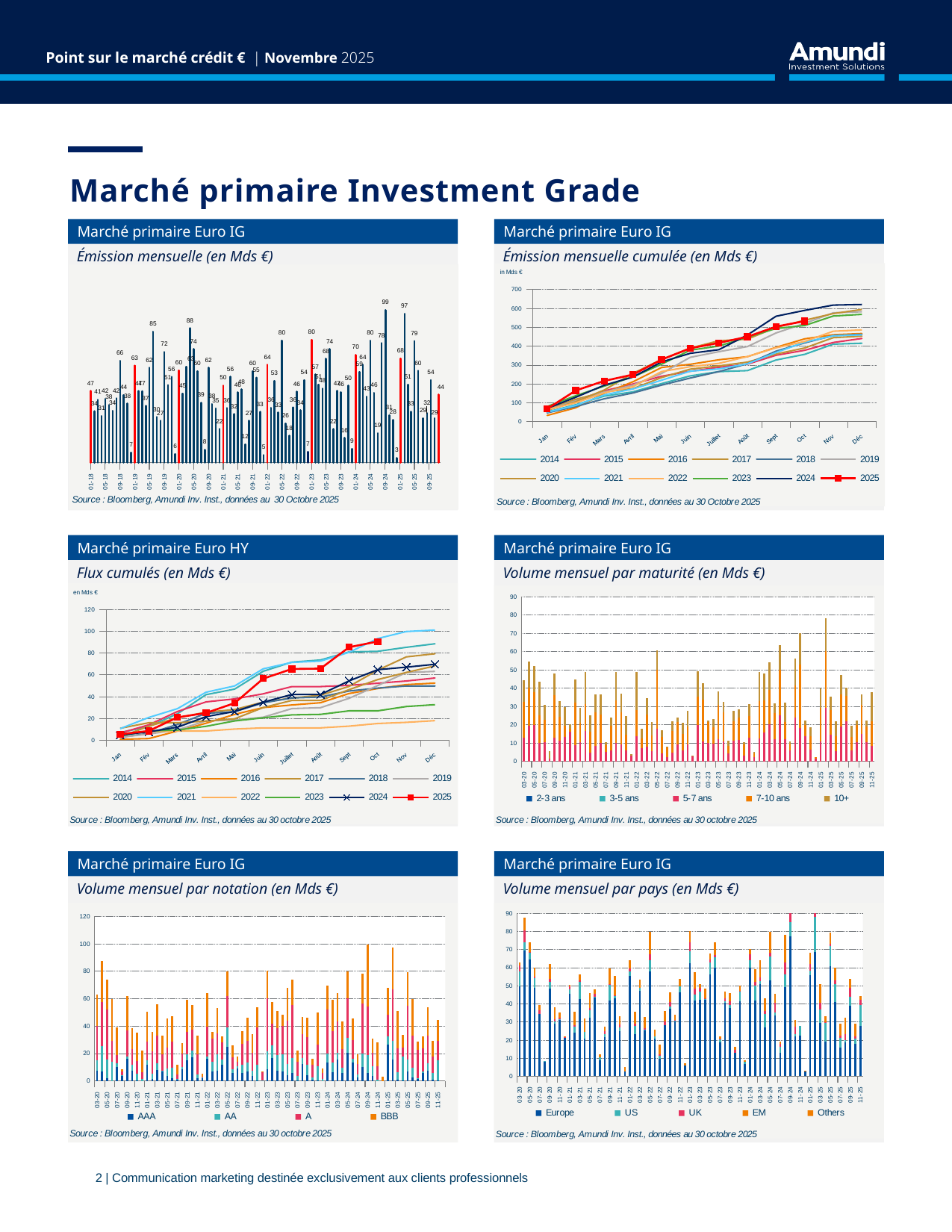
How many series does the legend of the top-right chart 'Émission mensuelle cumulée (en Mds €)' list? 12 How many series does the legend of the bottom-left chart 'Volume mensuel par notation (en Mds €)' list? 4 In the top-left chart 'Émission mensuelle (en Mds €)', what is the value labelled for 01-18? 47 How many months are shown on the x axis of the top-right chart 'Émission mensuelle cumulée (en Mds €)'? 12 What kind of chart is the top-left chart, 'Émission mensuelle (en Mds €)'? bar chart In the top-left chart 'Émission mensuelle (en Mds €)', what is the highest labelled monthly value? 99 In the top-right chart 'Émission mensuelle cumulée (en Mds €)', is the 2025 value at Oct greater or less than 500? greater How many series does the legend of the middle-right chart 'Volume mensuel par maturité (en Mds €)' list? 5 In the top-right chart 'Émission mensuelle cumulée (en Mds €)', does the 2025 line rise or fall from Jan to Oct? rise Which series are listed in the legend of the bottom-right chart 'Volume mensuel par pays (en Mds €)'? Europe, US, UK, EM, Others What kind of chart is the top-right chart, 'Émission mensuelle cumulée (en Mds €)'? line chart In the middle-left chart 'Flux cumulés (en Mds €)' for Euro HY, is the 2025 value at Oct greater or less than 80? greater